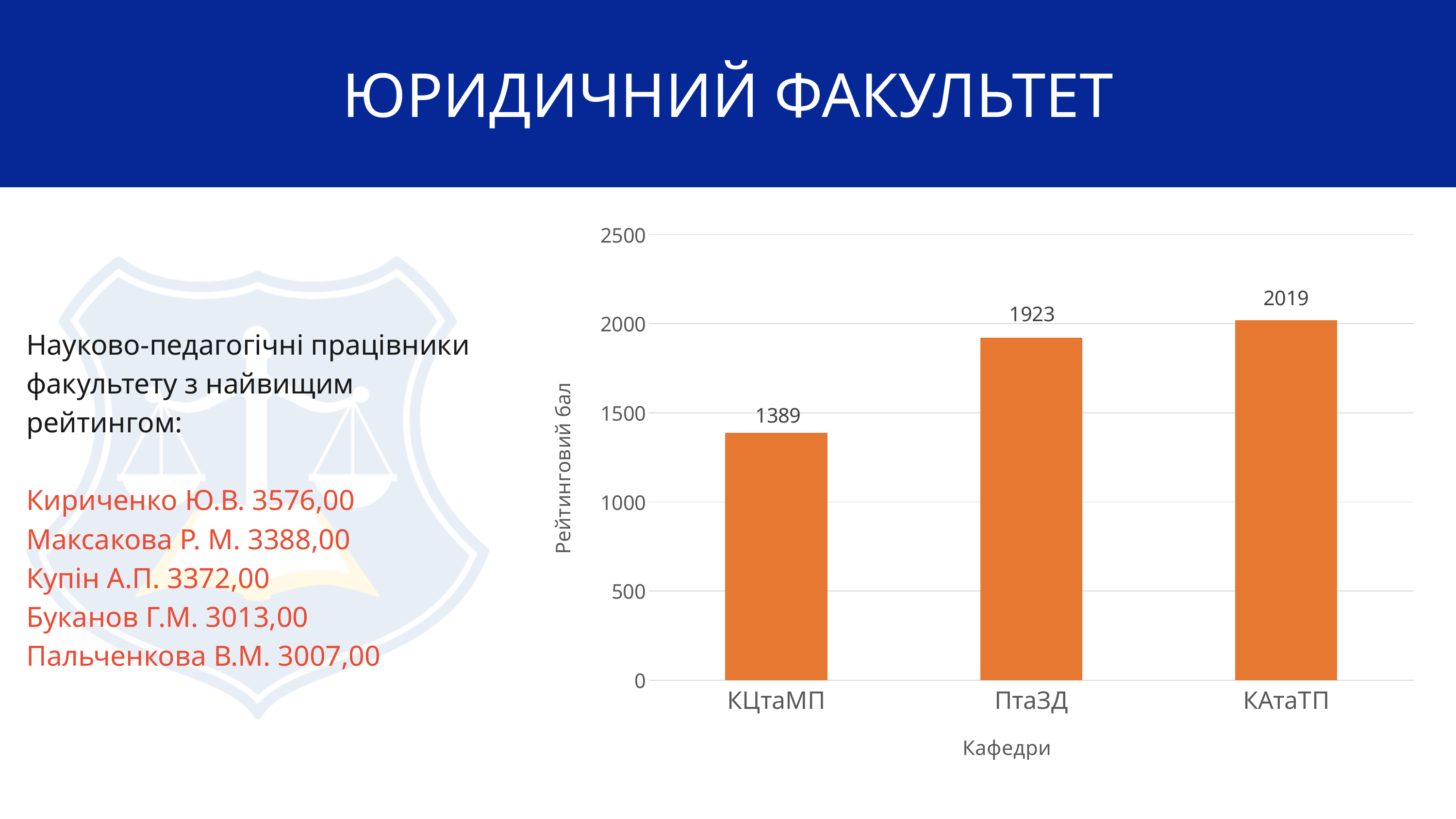
What kind of chart is shown on the slide? bar chart What is the rating score for КАтаТП? 2019 Which department (кафедра) has the highest rating score? КАтаТП What is the rating score (Рейтинговий бал) for КЦтаМП? 1389 Which has a higher rating score, ПтаЗД or КЦтаМП? ПтаЗД What is the rating score for ПтаЗД? 1923 How many departments are shown on the chart? 3 What is the difference between the rating scores of КАтаТП and КЦтаМП? 630 What is the difference between the rating scores of ПтаЗД and КЦтаМП? 534 Which department has the lowest rating score? КЦтаМП What is the label of the x axis of the chart? Кафедри Is the value for КЦтаМП greater or less than 1500? less